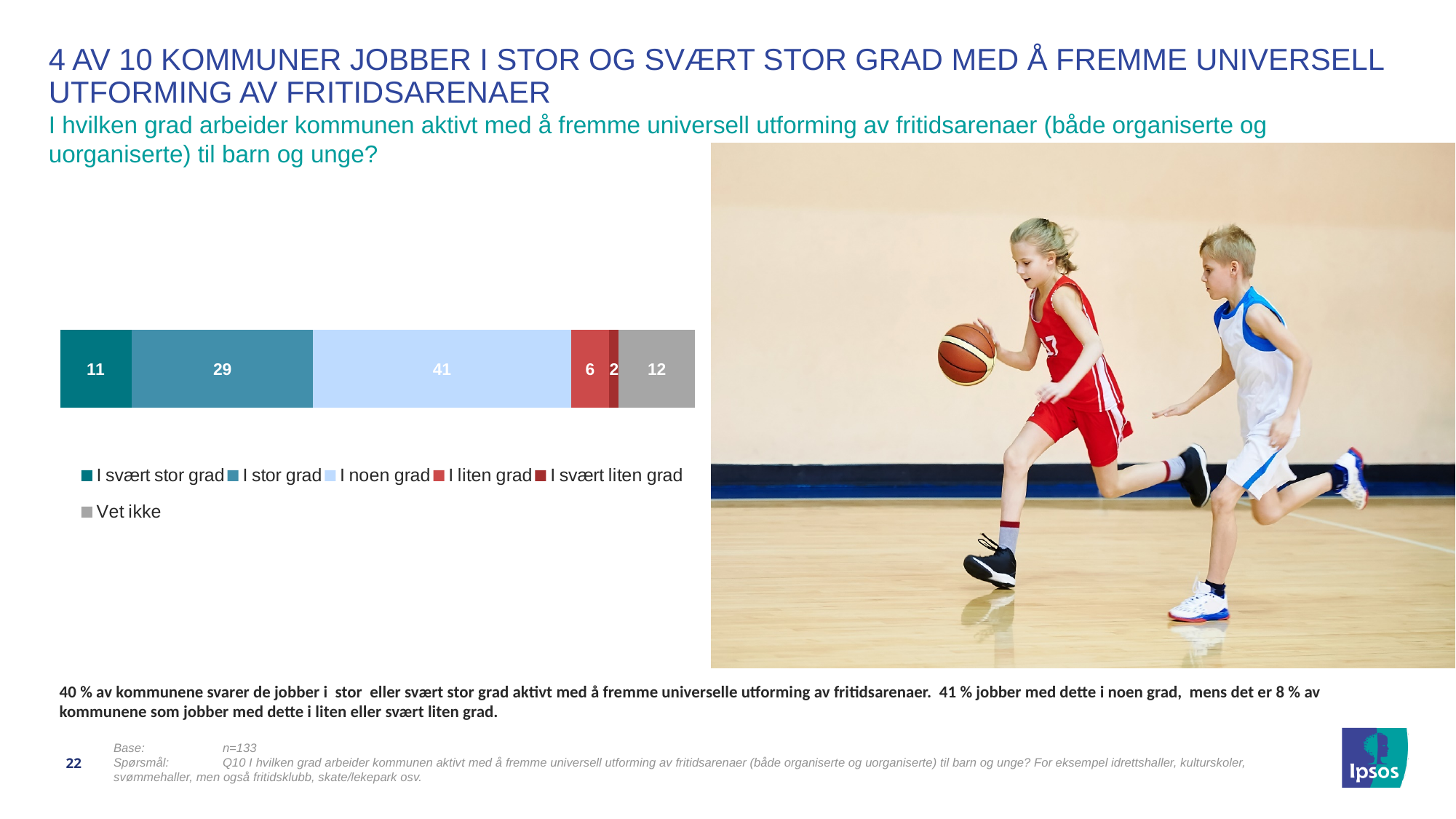
What value is shown for "I noen grad" in the stacked bar? 41 Which response category has the largest segment in the bar? I noen grad What value is shown for "Vet ikke" in the stacked bar? 12 What value is shown for "I svært stor grad" in the stacked bar? 11 What kind of chart is shown on the slide? Stacked bar chart How many response categories does the legend list? 6 What colour is the segment for "Vet ikke"? Grey What is the combined value of "I svært stor grad" and "I stor grad"? 40 What value is shown for "I svært liten grad" in the stacked bar? 2 Which is larger, the value for "I liten grad" or the value for "Vet ikke"? Vet ikke Which response category has the smallest segment in the bar? I svært liten grad What is the difference between the values for "I stor grad" and "I svært stor grad"? 18